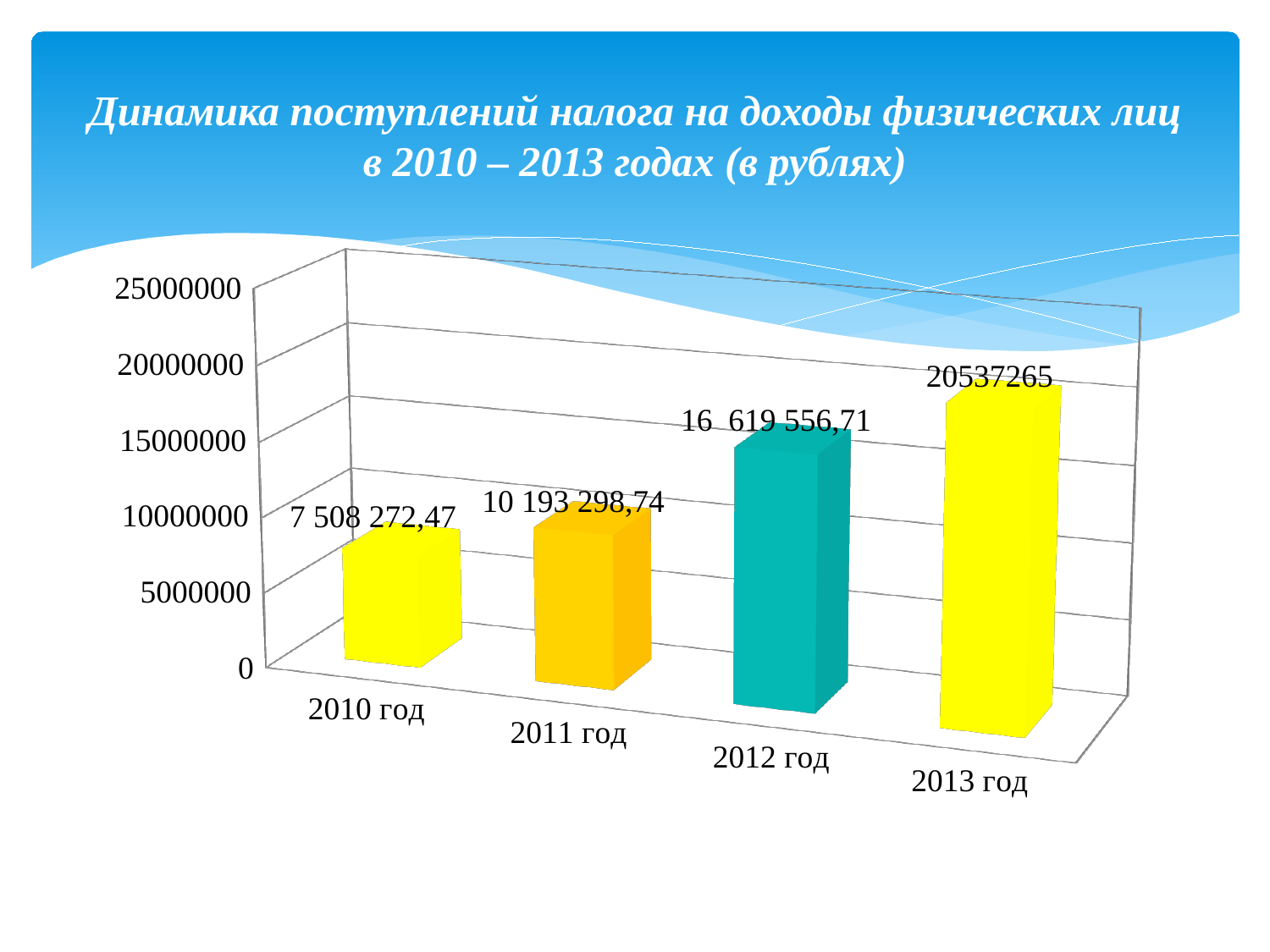
What is the value for 2010 год? 7 508 272,47 What is the difference between the values for 2013 год and 2012 год? 3 917 708,29 How many years are shown on the chart? 4 What is the difference between the values for 2011 год and 2010 год? 2 685 026,27 What is the value for 2013 год? 20537265 Which year has the highest value? 2013 год Is the value for 2010 год greater or less than 10000000? less What is the value for 2012 год? 16 619 556,71 What is the value for 2011 год? 10 193 298,74 Which is larger, the value for 2011 год or the value for 2012 год? 2012 год Which year has the lowest value? 2010 год Do the values rise or fall from 2010 год to 2013 год? rise